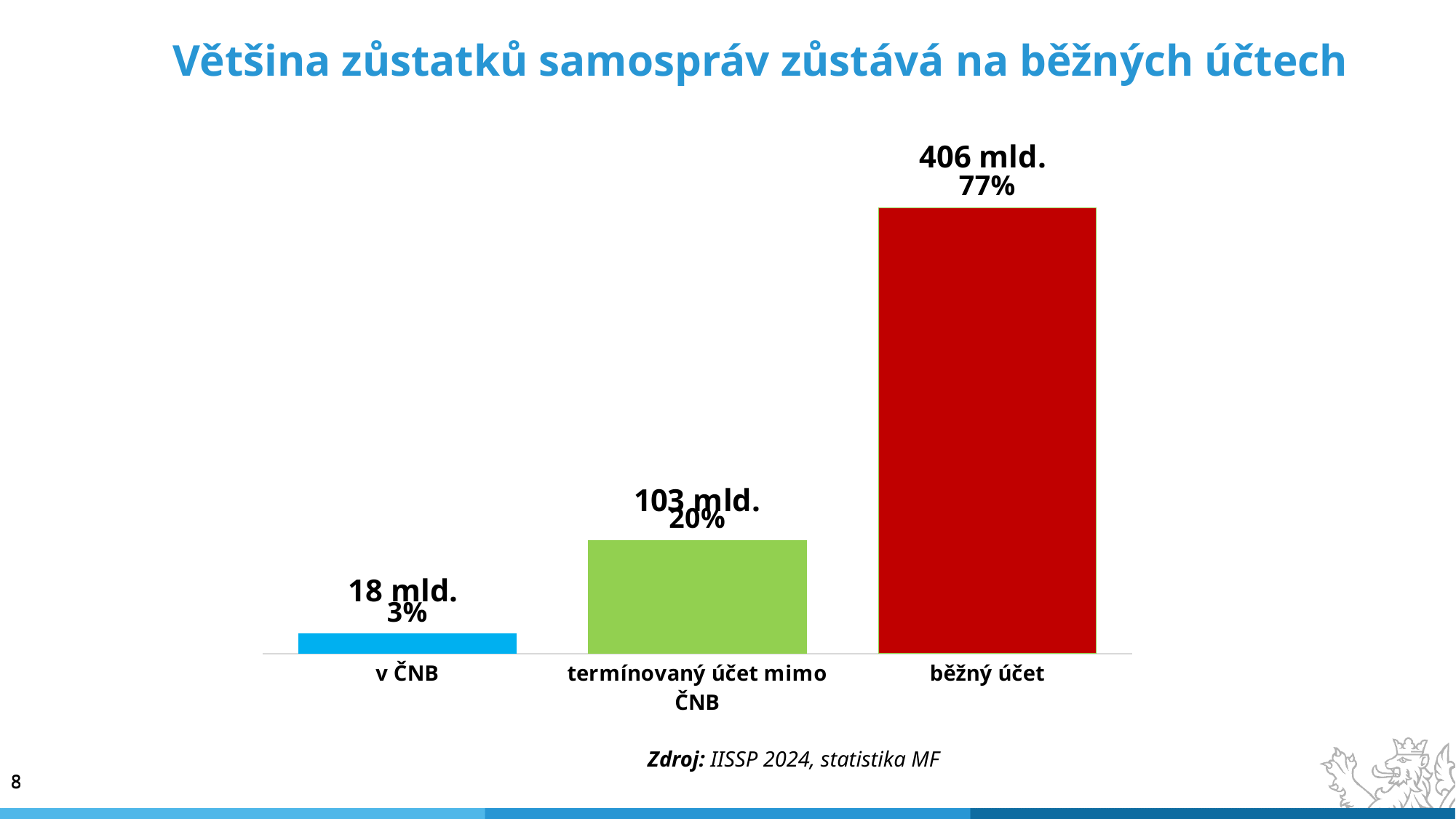
What value is shown for the "běžný účet" bar? 406 mld. What value is shown for the "v ČNB" bar? 18 mld. What value is shown for the "termínovaný účet mimo ČNB" bar? 103 mld. What is the title of the slide? Většina zůstatků samospráv zůstává na běžných účtech What percentage is shown above the "v ČNB" bar? 3% Which is larger, the value for "termínovaný účet mimo ČNB" or the value for "v ČNB"? termínovaný účet mimo ČNB What percentage is shown above the "termínovaný účet mimo ČNB" bar? 20% Which category has the highest value? běžný účet Which category has the lowest value? v ČNB How many categories are shown in the chart? 3 What is the difference in mld. between "běžný účet" and "termínovaný účet mimo ČNB"? 303 mld. What type of chart is shown on the slide? bar chart